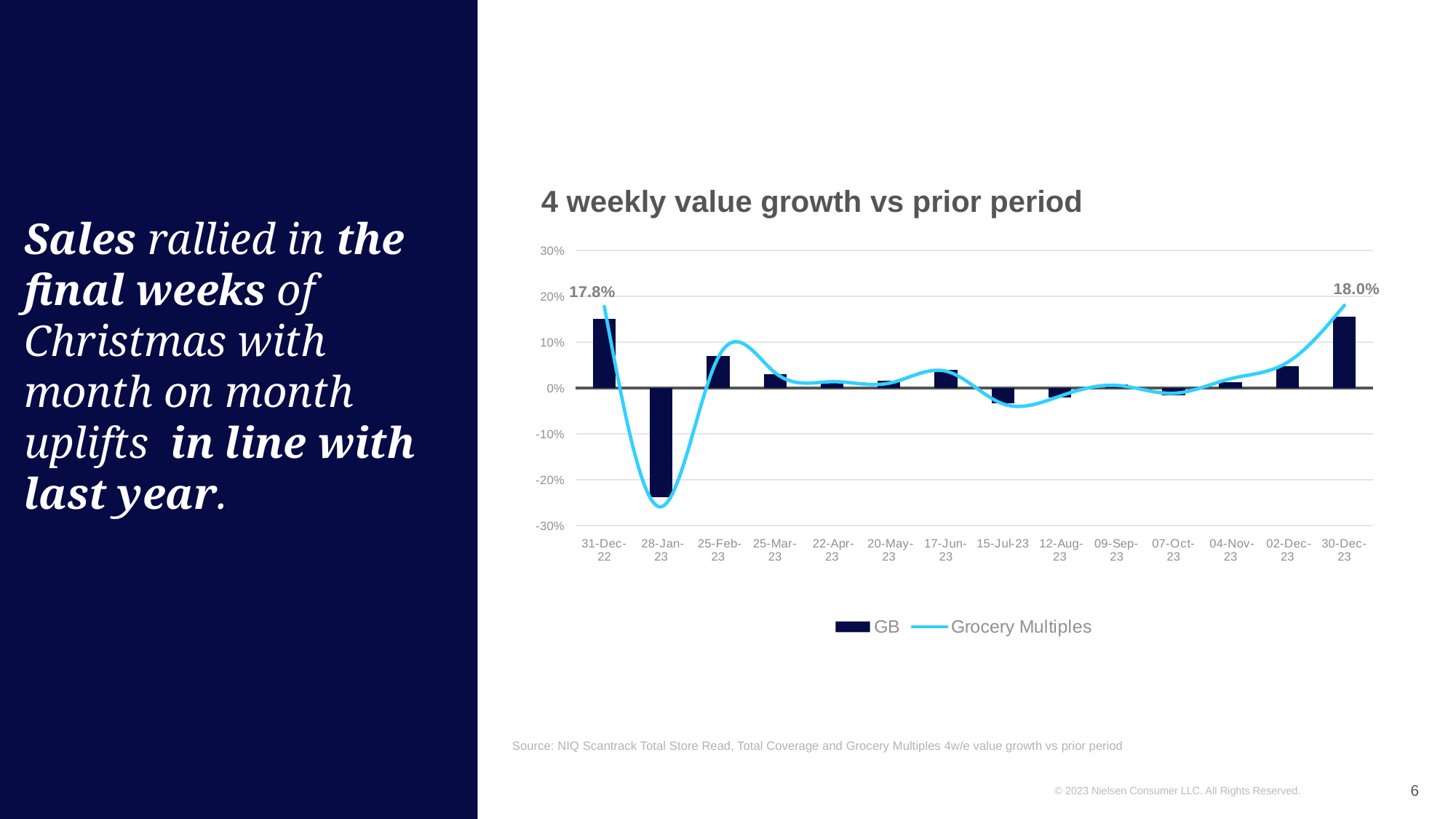
What kind of chart is shown on the slide? Combined bar and line chart Which is larger, the GB value for 31-Dec-22 or for 25-Feb-23? 31-Dec-22 Which two series are listed in the legend? GB and Grocery Multiples What is the title of the chart? 4 weekly value growth vs prior period Is the Grocery Multiples value for 28-Jan-23 greater or less than -20%? less What data label is shown at the 31-Dec-22 point? 17.8% How many series does the legend list? 2 Is the GB value for 31-Dec-22 greater or less than 10%? greater Is the GB value for 28-Jan-23 greater or less than -20%? less How many periods are shown along the x axis? 14 Which period has the lowest GB bar? 28-Jan-23 What data label is shown at the 30-Dec-23 point? 18.0%